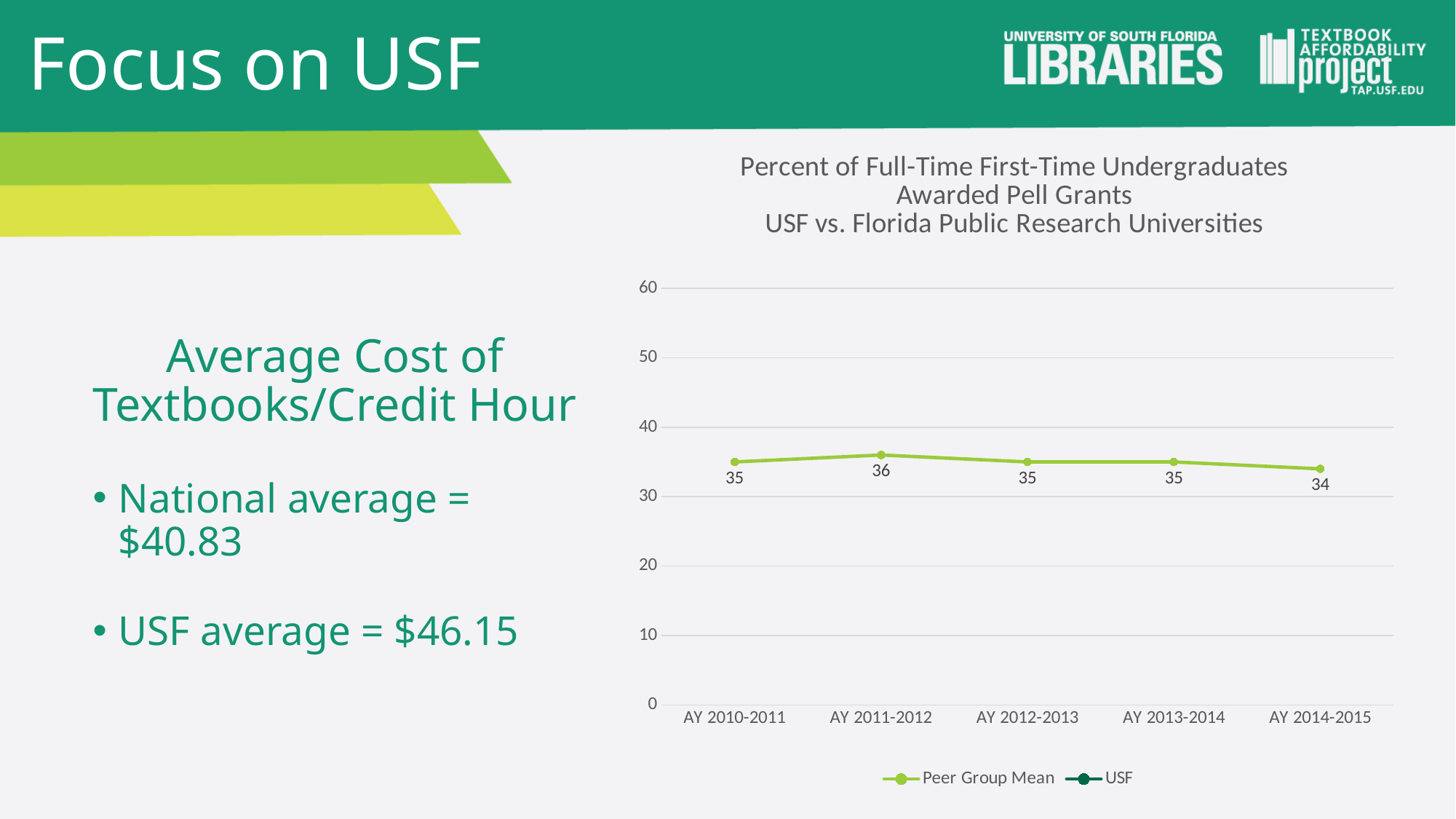
How many academic years are shown on the x axis? 5 What type of chart is shown on the slide? line chart In which academic year is the Peer Group Mean lowest? AY 2014-2015 What is the Peer Group Mean value for AY 2014-2015? 34 Is the Peer Group Mean for AY 2012-2013 greater or less than 40? less What is the Peer Group Mean value for AY 2011-2012? 36 Which is larger, the Peer Group Mean for AY 2011-2012 or for AY 2014-2015? AY 2011-2012 How many series does the legend list? 2 In which academic year is the Peer Group Mean highest? AY 2011-2012 What is the difference between the Peer Group Mean for AY 2011-2012 and AY 2014-2015? 2 What is the title of the chart? Percent of Full-Time First-Time Undergraduates Awarded Pell Grants USF vs. Florida Public Research Universities What is the Peer Group Mean value for AY 2010-2011? 35